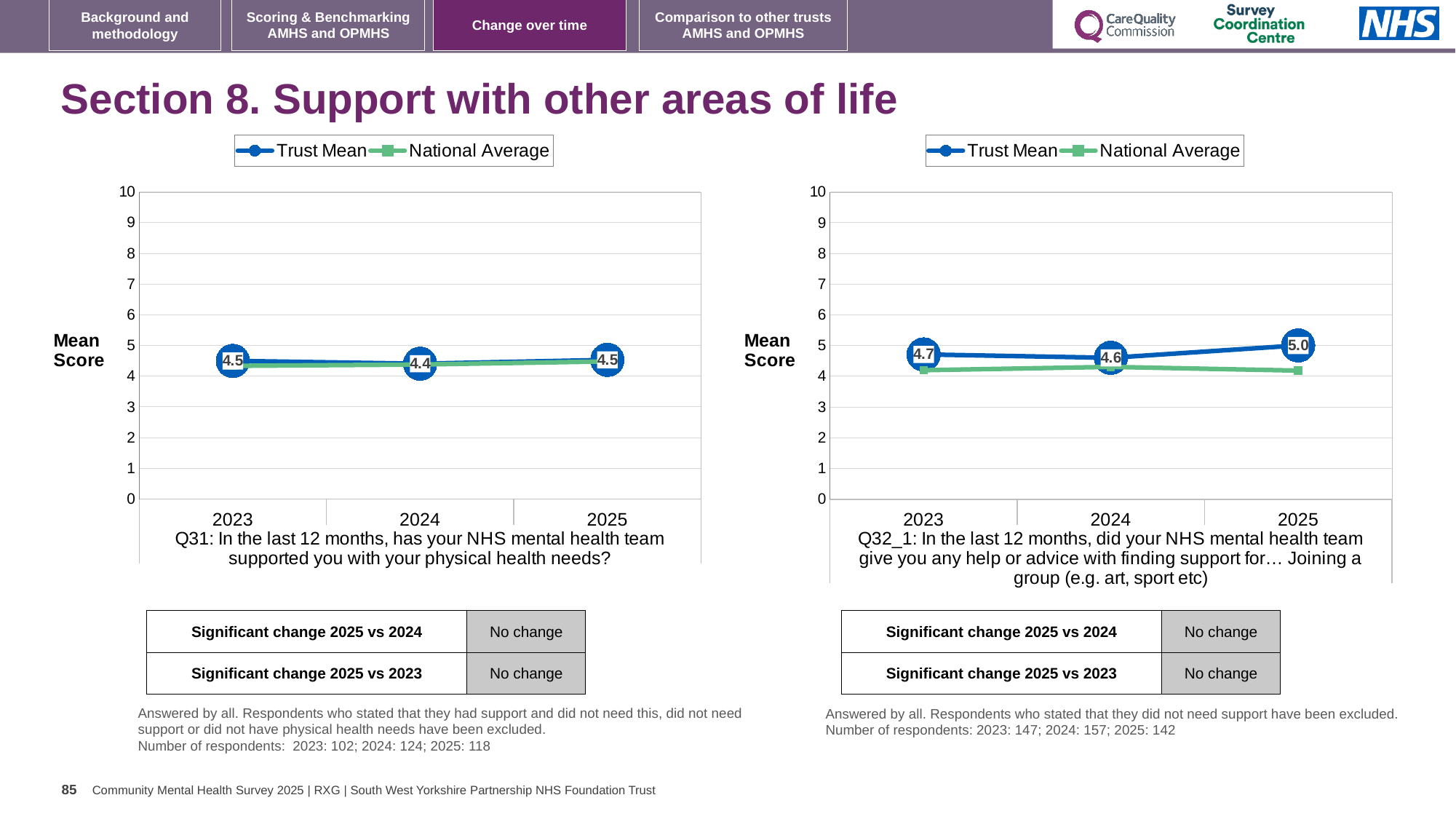
On the Q31 chart (left), what is the Trust Mean for 2024? 4.4 On the Q32_1 chart (right), is the National Average for 2025 greater or less than 5? less On the Q31 chart (left), what is the Trust Mean for 2025? 4.5 On the Q32_1 chart (right), is the Trust Mean for 2025 greater or less than the Trust Mean for 2023? greater On the Q32_1 chart (right), in which year is the Trust Mean highest? 2025 How many series does the legend of the Q32_1 chart (right) list? 2 What kind of chart is the Q31 chart (left)? Line chart How many years are plotted on the x axis of the Q31 chart (left)? 3 On the Q32_1 chart (right), what is the Trust Mean for 2023? 4.7 On the Q32_1 chart (right), what is the difference between the Trust Mean for 2025 and for 2024? 0.4 On the Q31 chart (left), in which year is the Trust Mean lowest? 2024 On the Q32_1 chart (right), what is the Trust Mean for 2025? 5.0